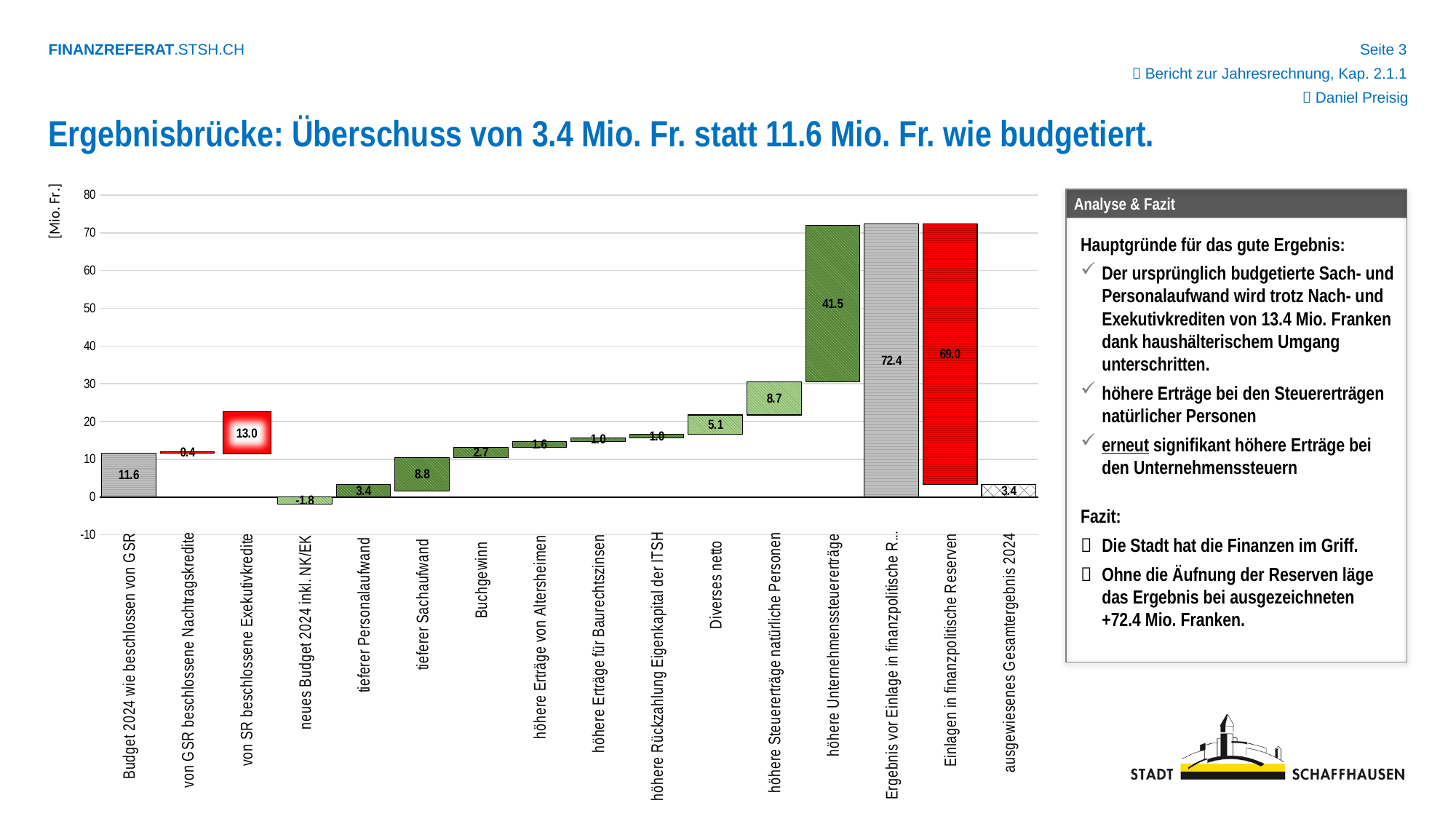
What is the value shown for 'Einlagen in finanzpolitische Reserven'? 69.0 What is the value shown for 'tieferer Sachaufwand'? 8.8 What kind of chart is shown on the slide? Bar chart (waterfall) Which category has the highest value in the chart? Ergebnis vor Einlage in finanzpolitische R... Which category has the lowest value in the chart? neues Budget 2024 inkl. NK/EK What is the value shown for 'von SR beschlossene Exekutivkredite'? 13.0 What unit is given on the y axis of the chart? [Mio. Fr.] What is the value shown for 'höhere Unternehmenssteuererträge'? 41.5 Which is larger: the value for 'Diverses netto' or the value for 'Buchgewinn'? Diverses netto How many categories are shown on the x axis of the chart? 16 What is the value shown for 'ausgewiesenes Gesamtergebnis 2024'? 3.4 What is the difference between the values for 'tieferer Sachaufwand' and 'tieferer Personalaufwand'? 5.4